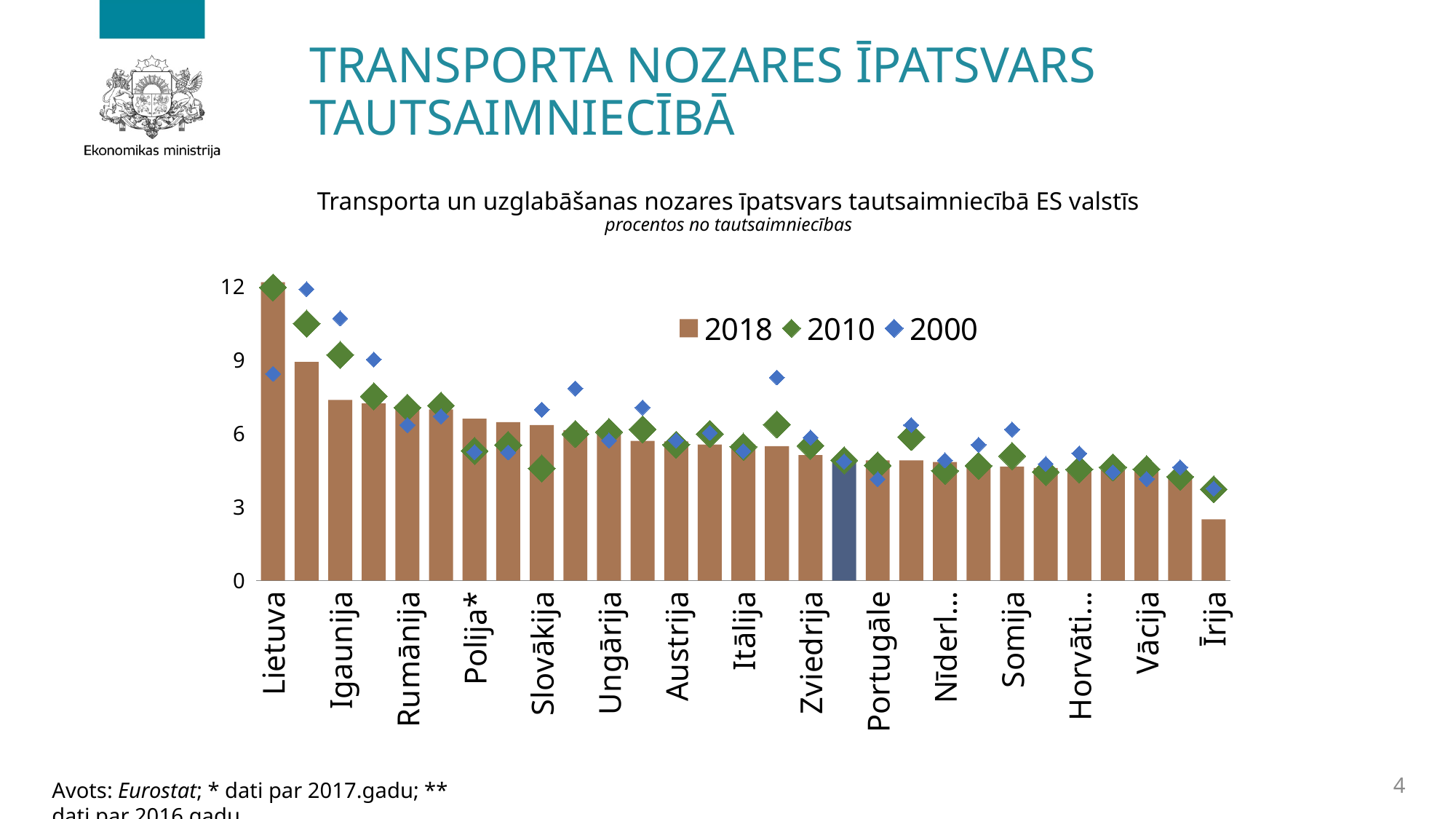
Which has the larger 2018 value, Rumānija or Vācija? Rumānija What kind of chart is shown on the slide? bar chart Is the 2018 value for Lietuva greater or less than 9? greater Do the 2018 bar values rise or fall from left to right along the x axis? fall Which country has the highest 2018 value? Lietuva Is the 2000 value for Igaunija greater or less than 9? greater Is the 2018 value for Vācija greater or less than 6? less How many series does the legend list? 3 Which country has the lowest 2018 value? Īrija What are the three entries in the chart legend? 2018, 2010, 2000